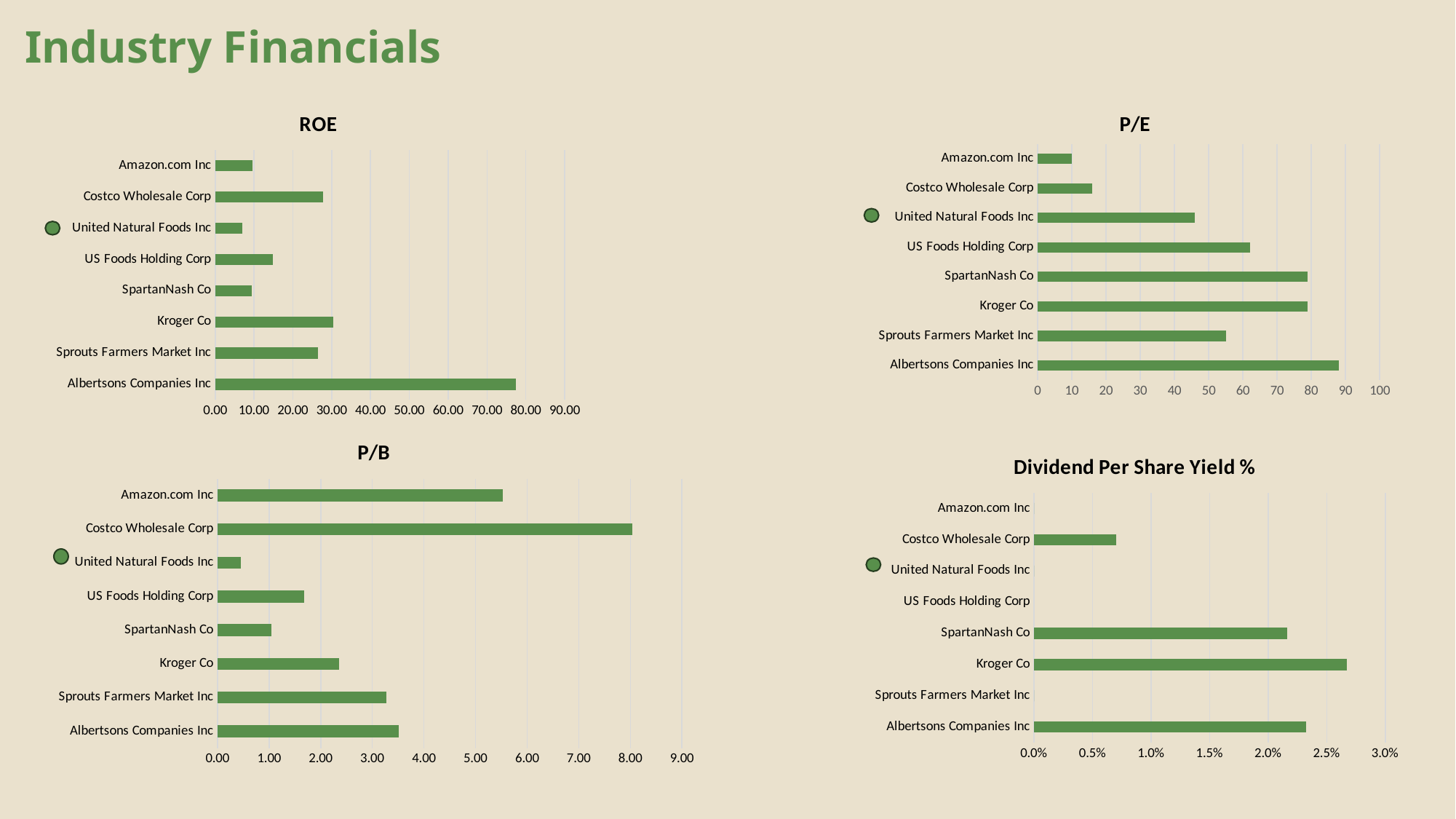
In the P/E chart, which company has the highest P/E? Albertsons Companies Inc In the ROE chart, is the value for Costco Wholesale Corp greater or less than 30.00? less In the ROE chart, which company has the highest ROE? Albertsons Companies Inc In the Dividend Per Share Yield % chart, which company has the highest dividend yield? Kroger Co In the P/E chart, is the value for United Natural Foods Inc greater or less than 50? less In the Dividend Per Share Yield % chart, is the value for Costco Wholesale Corp greater or less than 0.5%? greater How many companies are listed in the ROE chart? 8 In the P/E chart, which company has the lowest P/E? Amazon.com Inc In the P/B chart, which company has the lowest P/B? United Natural Foods Inc In the P/B chart, which is larger, the value for Kroger Co or the value for US Foods Holding Corp? Kroger Co